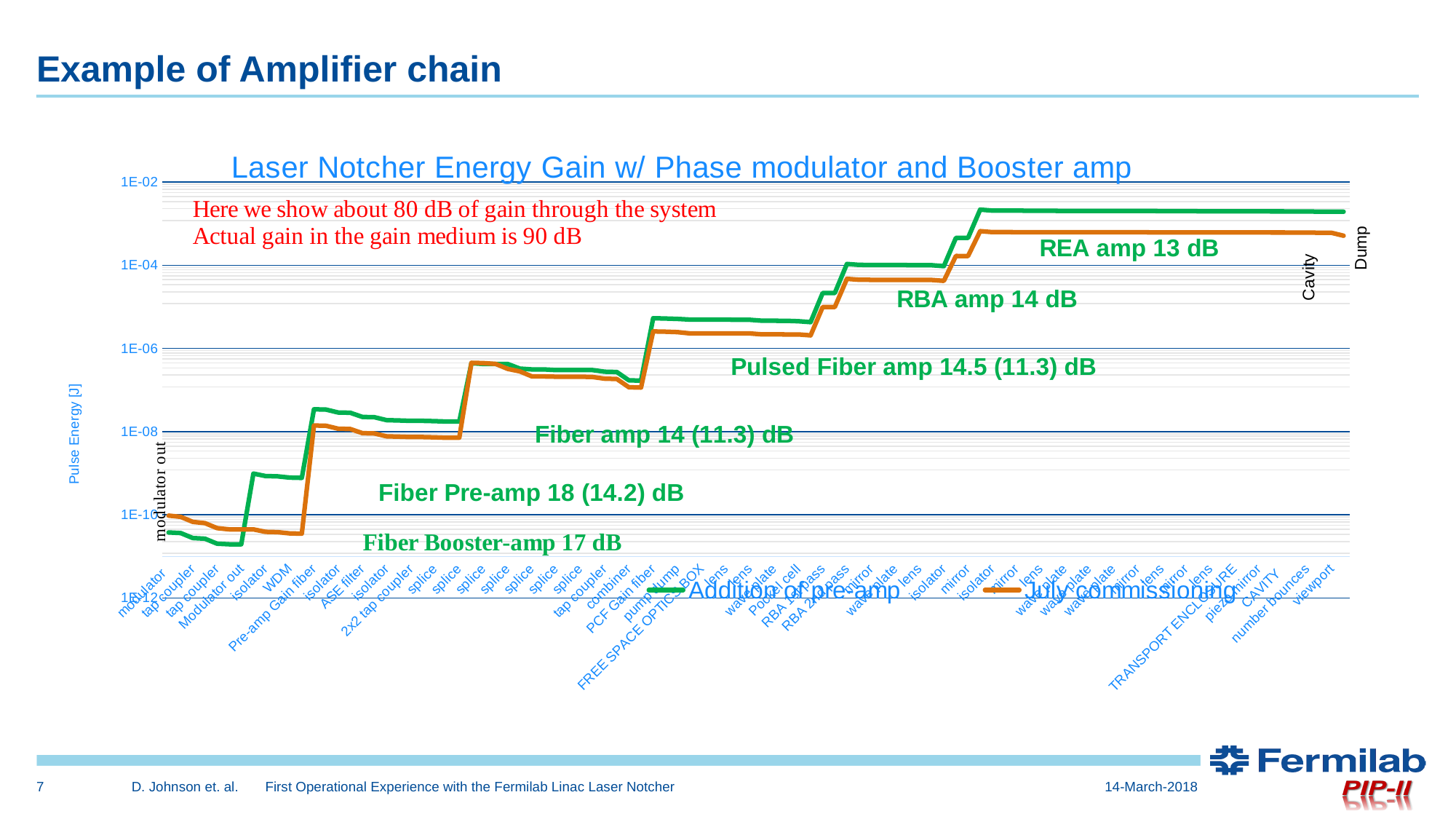
At the right end of the chart (viewport), which series has the higher pulse energy, Addition of pre-amp or July commissioning? Addition of pre-amp Is the final value of the Addition of pre-amp series greater or less than 1E-04? greater Is the value of the Addition of pre-amp series at Pre-amp Gain fiber greater or less than 1E-08? greater Is the final value of the July commissioning series greater or less than 1E-04? greater What kind of chart is shown on the slide? line chart Do the plotted pulse energy values generally rise or fall from left to right along the x axis? rise How many series does the legend list? 2 What is the title of the chart? Laser Notcher Energy Gain w/ Phase modulator and Booster amp What is the label of the vertical axis? Pulse Energy [J]